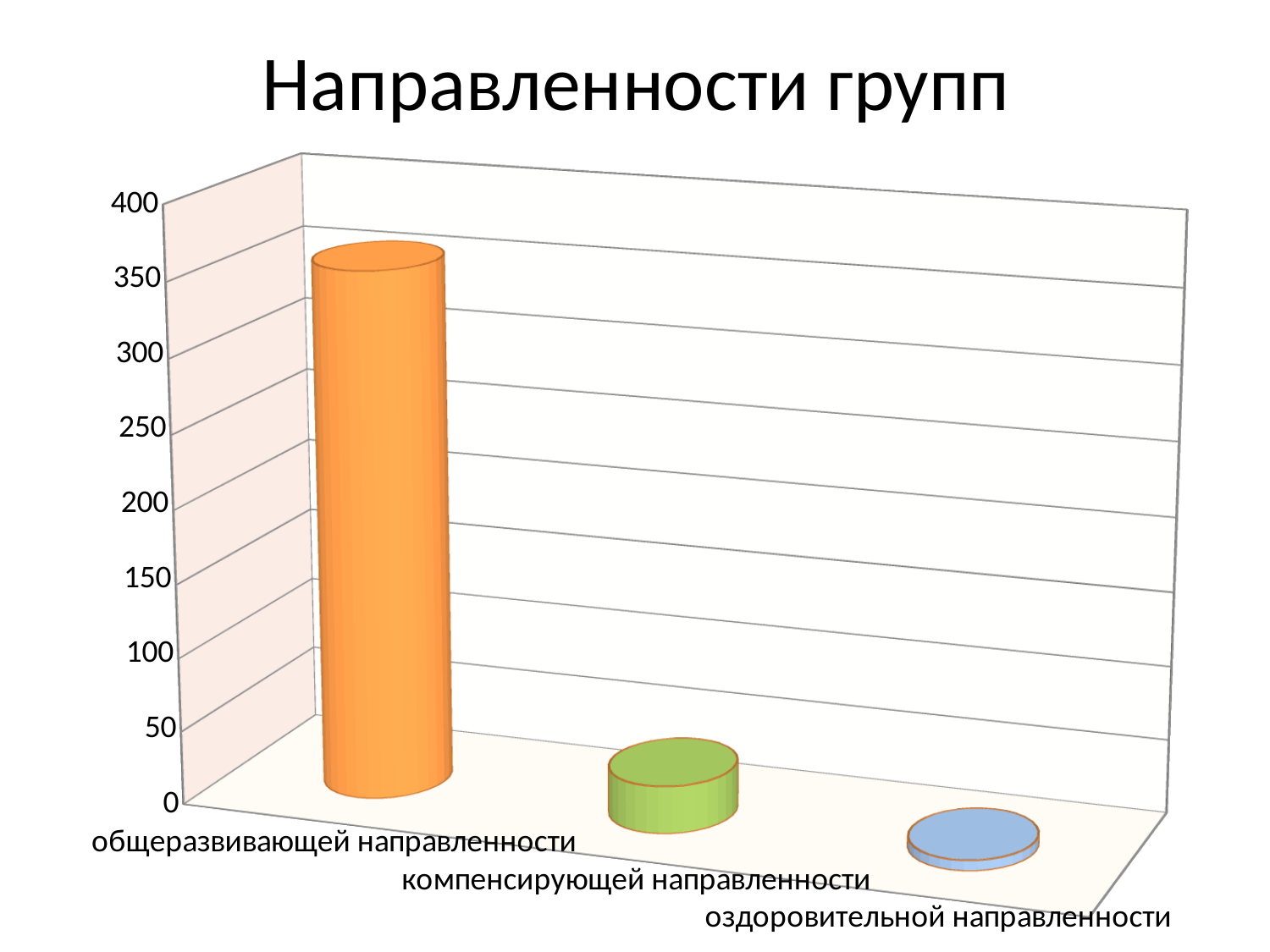
Which is larger: the value for компенсирующей направленности or the value for оздоровительной направленности? компенсирующей направленности Is the value for компенсирующей направленности greater or less than 100? less Which is larger: the value for общеразвивающей направленности or the value for компенсирующей направленности? общеразвивающей направленности Which category has the highest value? общеразвивающей направленности Which category has the lowest value? оздоровительной направленности Is the value for общеразвивающей направленности greater or less than 300? greater What kind of chart is shown on the slide? bar chart How many categories are plotted in the chart? 3 Is the value for оздоровительной направленности greater or less than 50? less What colour is the bar for общеразвивающей направленности? orange Do the values rise or fall from left to right across the categories? fall What is the title of the chart? Направленности групп